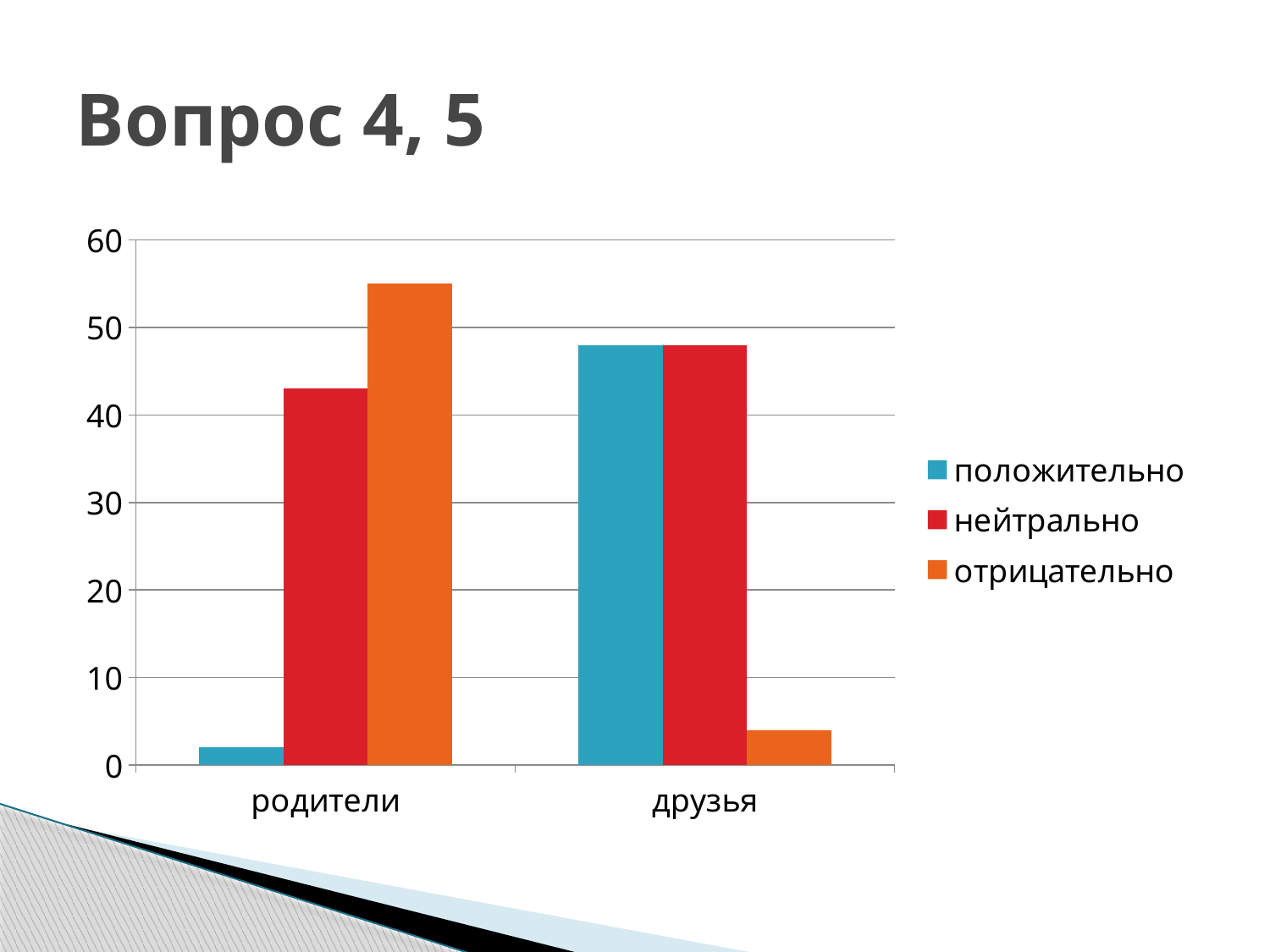
Which series has the lowest value for друзья? отрицательно Is the value for отрицательно for друзья greater or less than 10? less How many categories are shown on the x axis? 2 What is the title of the slide? Вопрос 4, 5 Which series has the highest value for родители? отрицательно Is the value for отрицательно for родители greater or less than 50? greater Which category has the larger value for положительно, родители or друзья? друзья Which series has the lowest value for родители? положительно Is the value for положительно for друзья greater or less than 50? less What kind of chart is shown on the slide? bar chart How many series does the legend list? 3